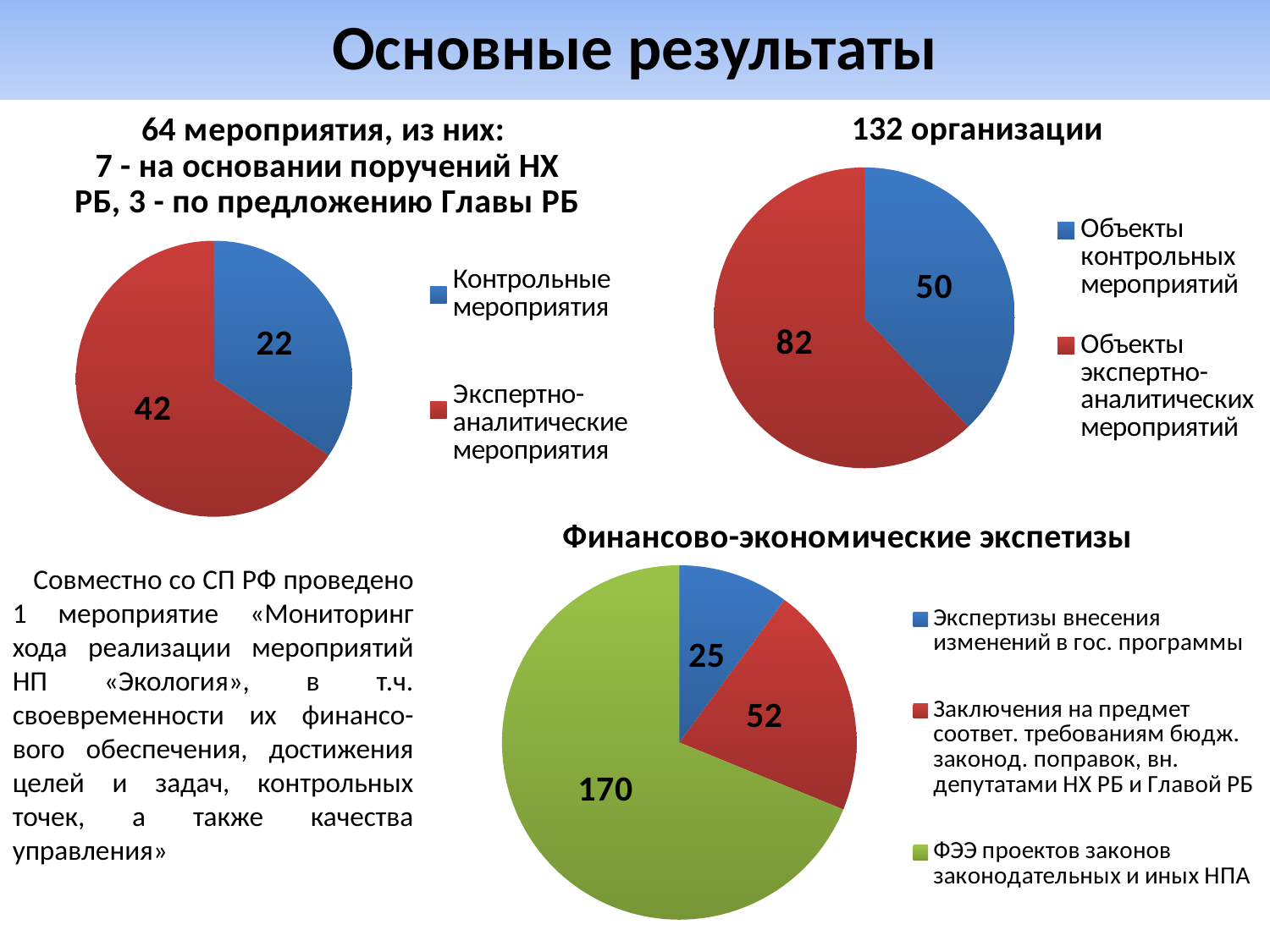
In the top-left pie chart ("64 мероприятия, из них..."), what is the value for "Экспертно-аналитические мероприятия"? 42 In the top-left pie chart ("64 мероприятия, из них..."), what is the difference between "Экспертно-аналитические мероприятия" and "Контрольные мероприятия"? 20 In the pie chart titled "Финансово-экономические экспетизы", which category has the largest value? ФЭЭ проектов законов законодательных и иных НПА What type of chart is the chart titled "132 организации"? Pie chart In the pie chart titled "132 организации", what is the value for "Объекты контрольных мероприятий"? 50 In the pie chart titled "132 организации", what is the difference between the two slice values? 32 In the pie chart titled "132 организации", what is the value for "Объекты экспертно-аналитических мероприятий"? 82 In the pie chart titled "Финансово-экономические экспетизы", what is the value for "ФЭЭ проектов законов законодательных и иных НПА"? 170 In the pie chart titled "Финансово-экономические экспетизы", what colour is the slice for "Заключения на предмет соответ. требованиям бюдж. законод. поправок, вн. депутатами НХ РБ и Главой РБ"? Red In the pie chart titled "Финансово-экономические экспетизы", how many slices are there? 3 In the pie chart titled "Финансово-экономические экспетизы", which category has the smallest value? Экспертизы внесения изменений в гос. программы In the top-left pie chart ("64 мероприятия, из них..."), what is the value for "Контрольные мероприятия"? 22